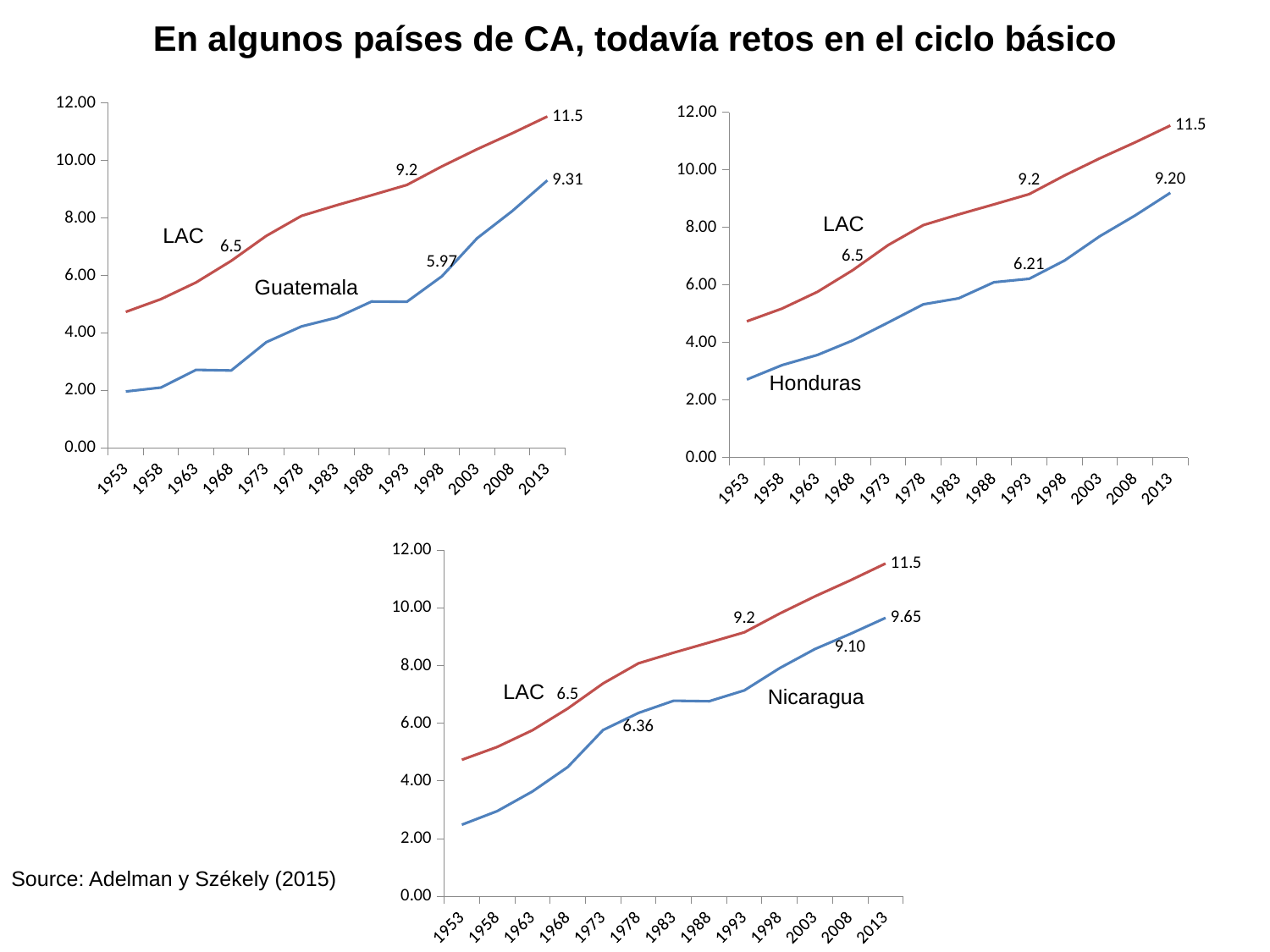
In the top-left chart, is the value for Guatemala in 1953 greater or less than 4.00? less What kind of chart is the top-right chart? line chart In the top-right chart, what is the difference between the LAC value and the Honduras value in 2013? 2.3 In the bottom chart, which line is higher in 2013, LAC or Nicaragua? LAC In the bottom chart, does the Nicaragua line generally rise or fall from 1953 to 2013? rise In the top-left chart, what is the value for LAC in 2013? 11.5 In the top-left chart, what is the difference between the LAC value and the Guatemala value in 2013? 2.19 How many charts are shown on the slide? 3 In the top-right chart, what is the value for Honduras in 2013? 9.20 In the top-left chart, what is the value for Guatemala in 2013? 9.31 In the bottom chart, what is the value for Nicaragua in 2008? 9.10 In the bottom chart, what is the value for Nicaragua in 2013? 9.65